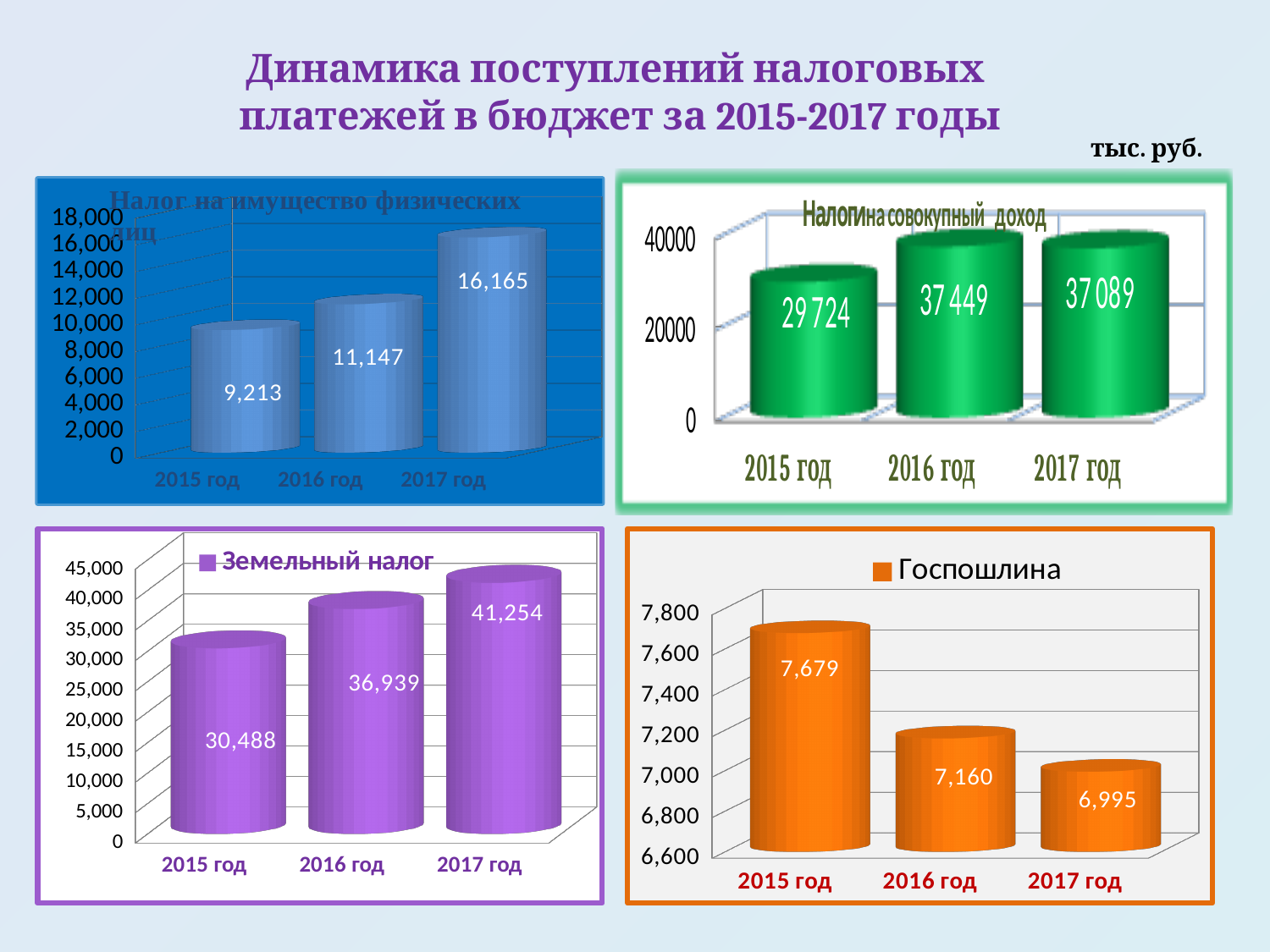
In the 'Налог на совокупный доход' chart (top right), is the value for 2016 год greater or less than 20000? greater In the 'Земельный налог' chart (bottom left), what is the value for 2016 год? 36,939 In the 'Налог на имущество физических лиц' chart (top left), what is the value for 2017 год? 16,165 In the 'Земельный налог' chart (bottom left), what is the difference between the 2017 год and 2016 год values? 4,315 How many charts are shown on the slide? 4 In the 'Налог на имущество физических лиц' chart (top left), which year has the lowest value? 2015 год In the 'Госпошлина' chart (bottom right), which is larger, the value for 2015 год or 2016 год? 2015 год In the 'Налог на имущество физических лиц' chart (top left), what is the difference between the 2017 год and 2015 год values? 6,952 In the 'Госпошлина' chart (bottom right), what is the value for 2017 год? 6,995 In the 'Налог на совокупный доход' chart (top right), what is the value for 2015 год? 29 724 In the 'Налог на совокупный доход' chart (top right), which year has the highest value? 2016 год In the 'Земельный налог' chart (bottom left), do the values rise or fall from 2015 год to 2017 год? rise